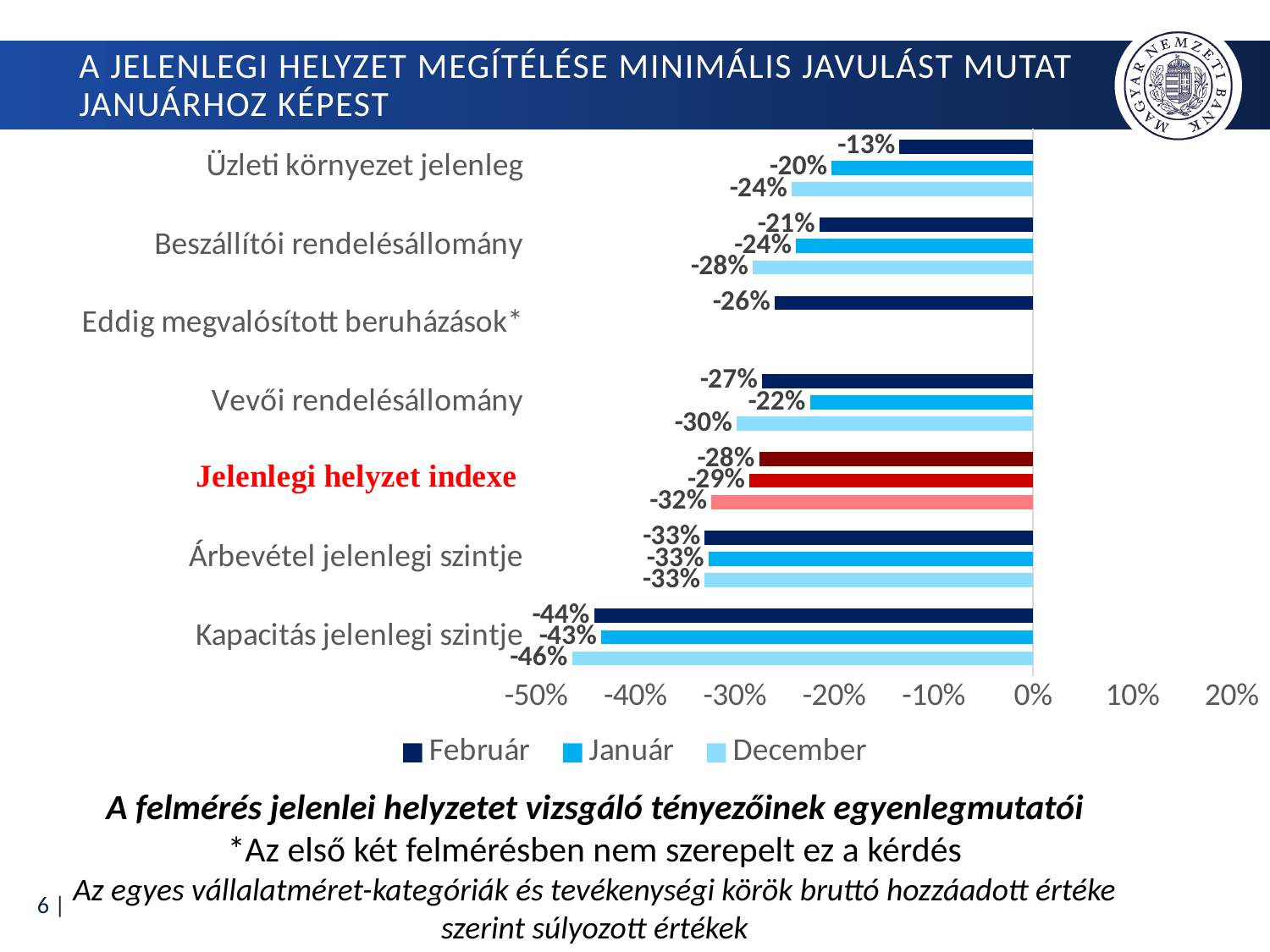
What kind of chart is shown on the slide? Bar chart What is the Január value for Vevői rendelésállomány? -22% What is the December value for Jelenlegi helyzet indexe? -32% What is the difference between the Február and December values for Üzleti környezet jelenleg? 11 percentage points What is the December value for Kapacitás jelenlegi szintje? -46% How many categories are shown on the chart? 7 Which category has the highest Február value? Üzleti környezet jelenleg Which category is shown in red bars instead of blue? Jelenlegi helyzet indexe Which is larger for Vevői rendelésállomány, the Február value or the Január value? Január What is the Február value for Üzleti környezet jelenleg? -13% Which category has the lowest Február value? Kapacitás jelenlegi szintje How many series does the legend list? 3